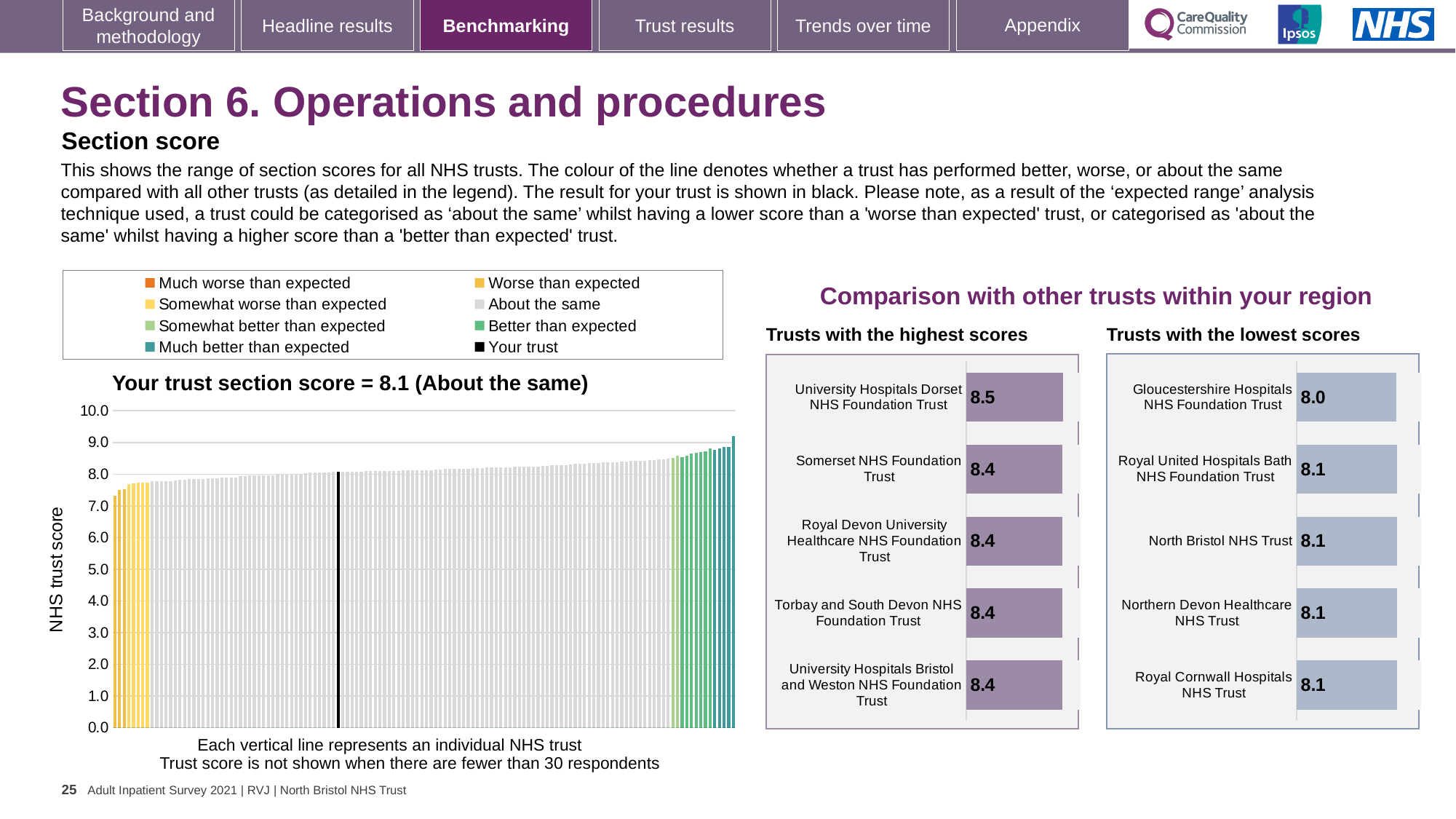
In the 'Trusts with the highest scores' chart, what is the difference between the scores of University Hospitals Dorset NHS Foundation Trust and Somerset NHS Foundation Trust? 0.1 How many entries does the legend above the 'Your trust section score' chart list? 8 In the 'Your trust section score' chart, is the value of the tallest bar greater or less than 9.0? greater In the 'Your trust section score' chart, what is the section score for your trust? 8.1 How many trusts are listed in the 'Trusts with the lowest scores' chart? 5 In the 'Your trust section score' chart, do the bar values rise or fall from left to right along the x axis? rise What type of chart is the 'Your trust section score' chart? bar chart In the 'Trusts with the lowest scores' chart, what is the score for Gloucestershire Hospitals NHS Foundation Trust? 8.0 In the 'Trusts with the highest scores' chart, what is the score for University Hospitals Dorset NHS Foundation Trust? 8.5 In the 'Trusts with the highest scores' chart, which trust has the highest score? University Hospitals Dorset NHS Foundation Trust In the 'Trusts with the lowest scores' chart, which trust has the lowest score? Gloucestershire Hospitals NHS Foundation Trust Which is larger: the score for University Hospitals Dorset NHS Foundation Trust in the highest scores chart, or the score for Gloucestershire Hospitals NHS Foundation Trust in the lowest scores chart? University Hospitals Dorset NHS Foundation Trust